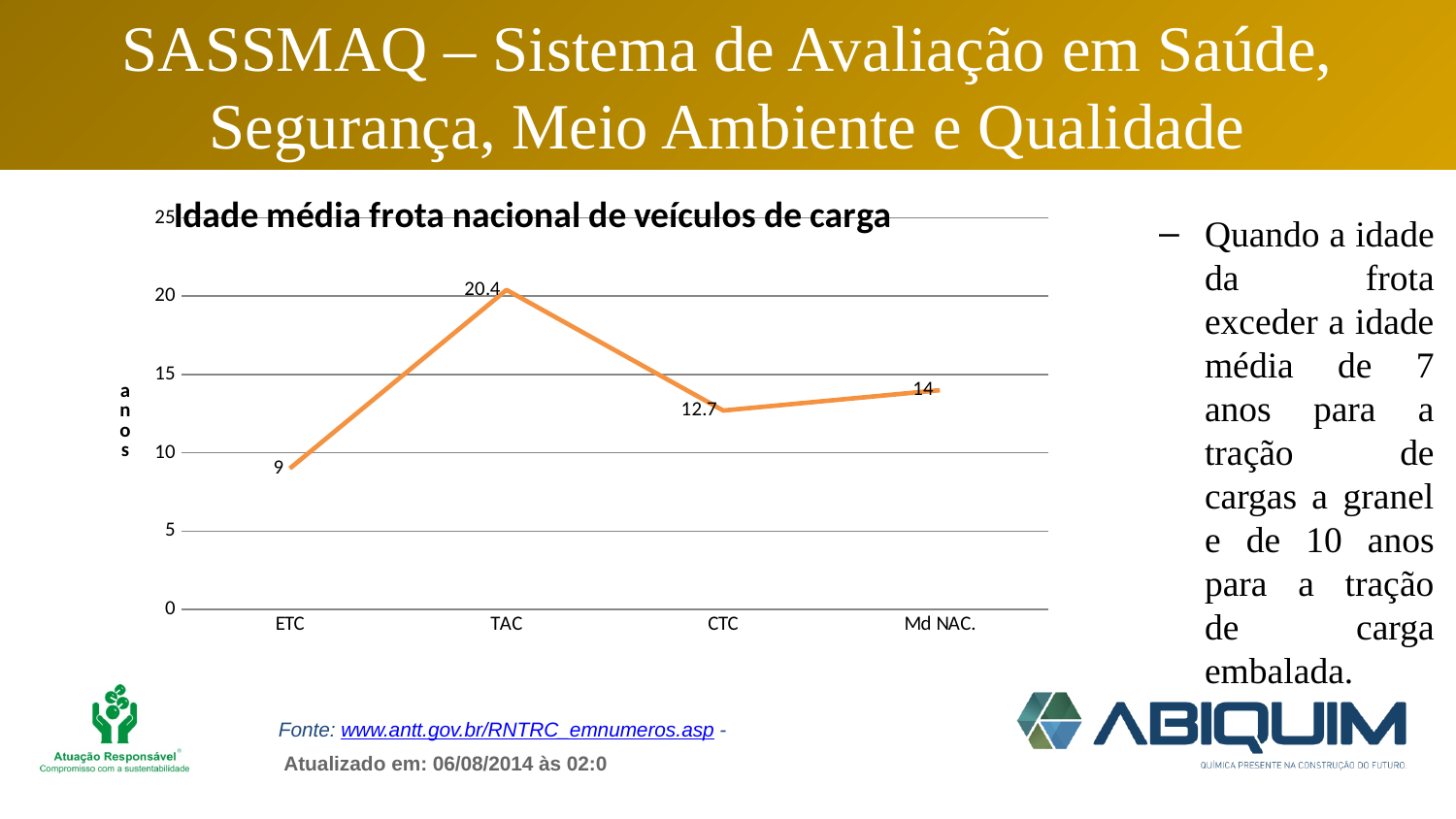
What is the value for TAC? 20.4 How many categories are shown on the x axis? 4 What is the title of the chart? Idade média frota nacional de veículos de carga Which category has the highest value? TAC What is the difference between the values for TAC and ETC? 11.4 What is the value for Md NAC.? 14 What is the value for ETC? 9 What kind of chart is this? line chart Which category has the lowest value? ETC What is the value for CTC? 12.7 Is the value for TAC greater or less than 20? greater Which is larger, the value for CTC or the value for Md NAC.? Md NAC.